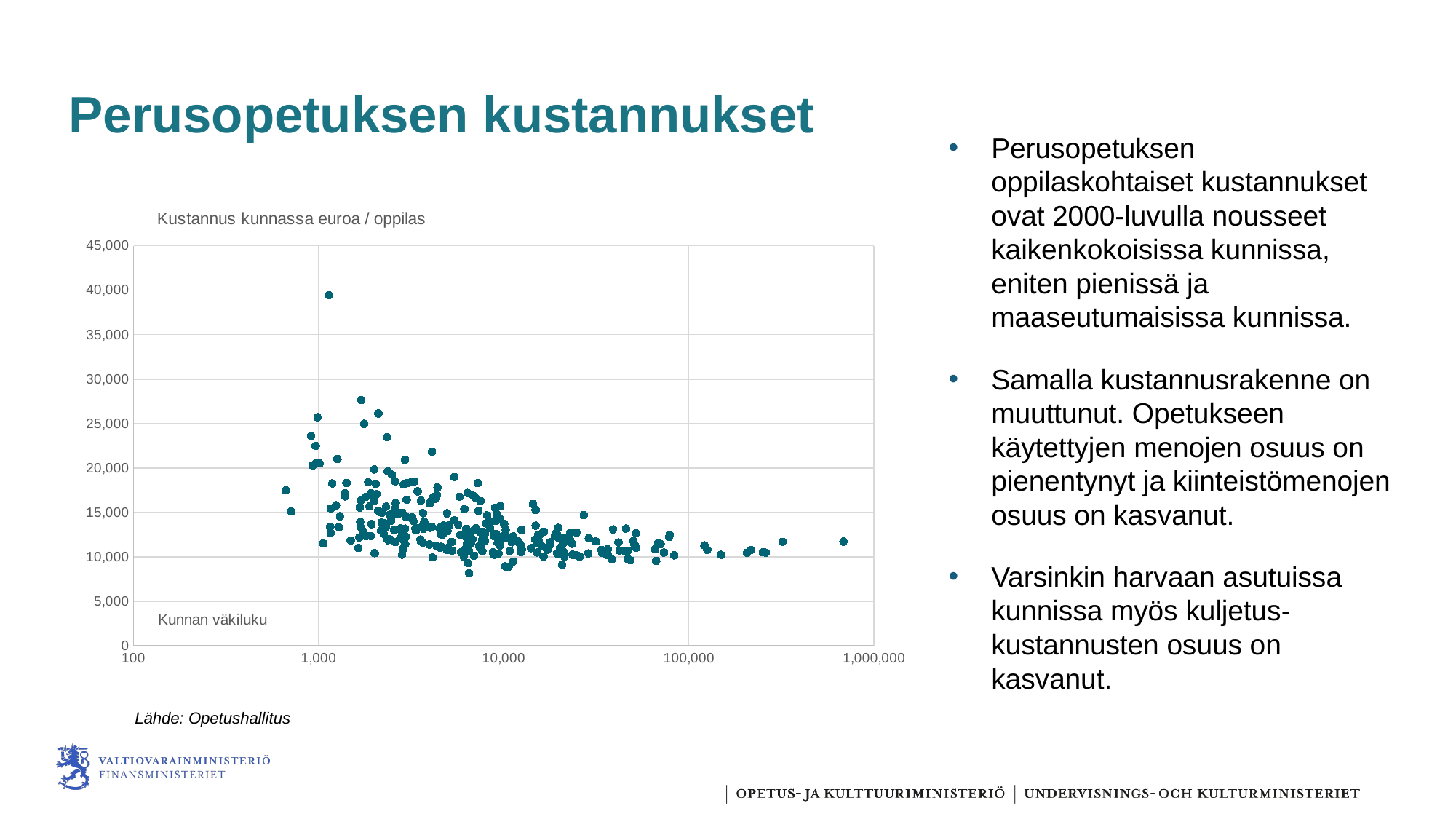
What is the label of the horizontal axis of the chart? Kunnan väkiluku Is the value of the highest point in the chart greater or less than 35,000? greater What is the label of the vertical axis of the chart? Kustannus kunnassa euroa / oppilas As the municipality population (Kunnan väkiluku) increases along the x axis, do the cost per pupil values generally rise or fall? Fall Is the value of the rightmost point in the chart (the municipality with the largest population) greater or less than 15,000? less Are the points for municipalities with a population above 100,000 all greater or less than 15,000 euroa / oppilas? less What kind of chart is shown on the slide? Scatter chart